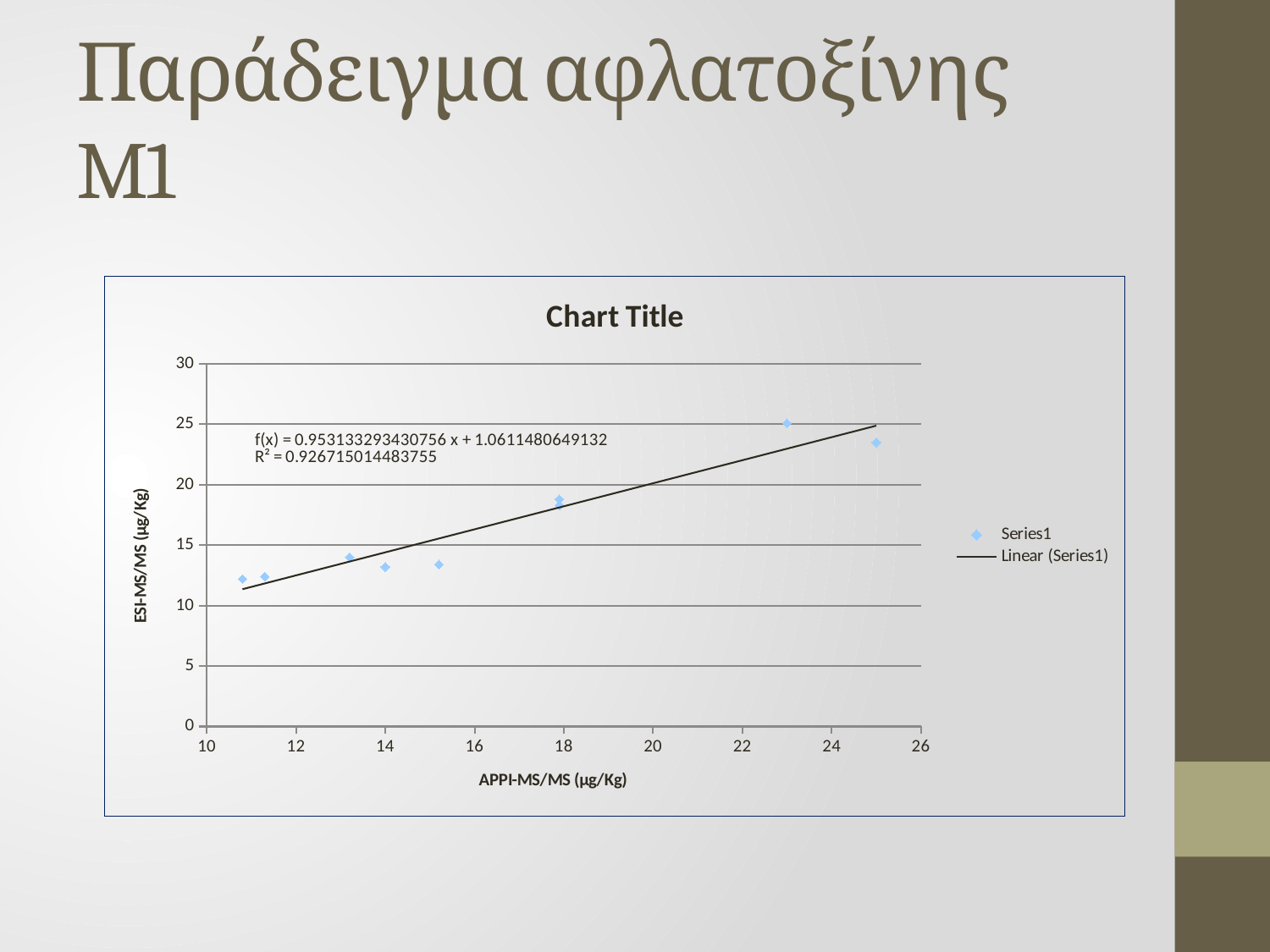
Which point has the highest ESI-MS/MS value: the one at APPI-MS/MS of about 23 or the one at about 25? the one at about 23 Is the ESI-MS/MS value for the point at APPI-MS/MS of about 18 greater or less than 15? greater What is the R² value shown on the chart? 0.926715014483755 What is the label of the x axis? APPI-MS/MS (μg/Kg) Which point has a higher ESI-MS/MS value: the one at APPI-MS/MS of about 14 or the one at about 18? the one at about 18 How many series does the legend list? 2 Do the ESI-MS/MS values generally rise or fall as APPI-MS/MS increases? rise What is the trendline equation shown on the chart? f(x) = 0.953133293430756 x + 1.0611480649132 Is the ESI-MS/MS value for the point at APPI-MS/MS of about 23 greater or less than 20? greater Is the ESI-MS/MS value for the point at APPI-MS/MS of about 11 greater or less than 15? less What kind of chart is shown on the slide? scatter chart What is the title of the chart? Chart Title